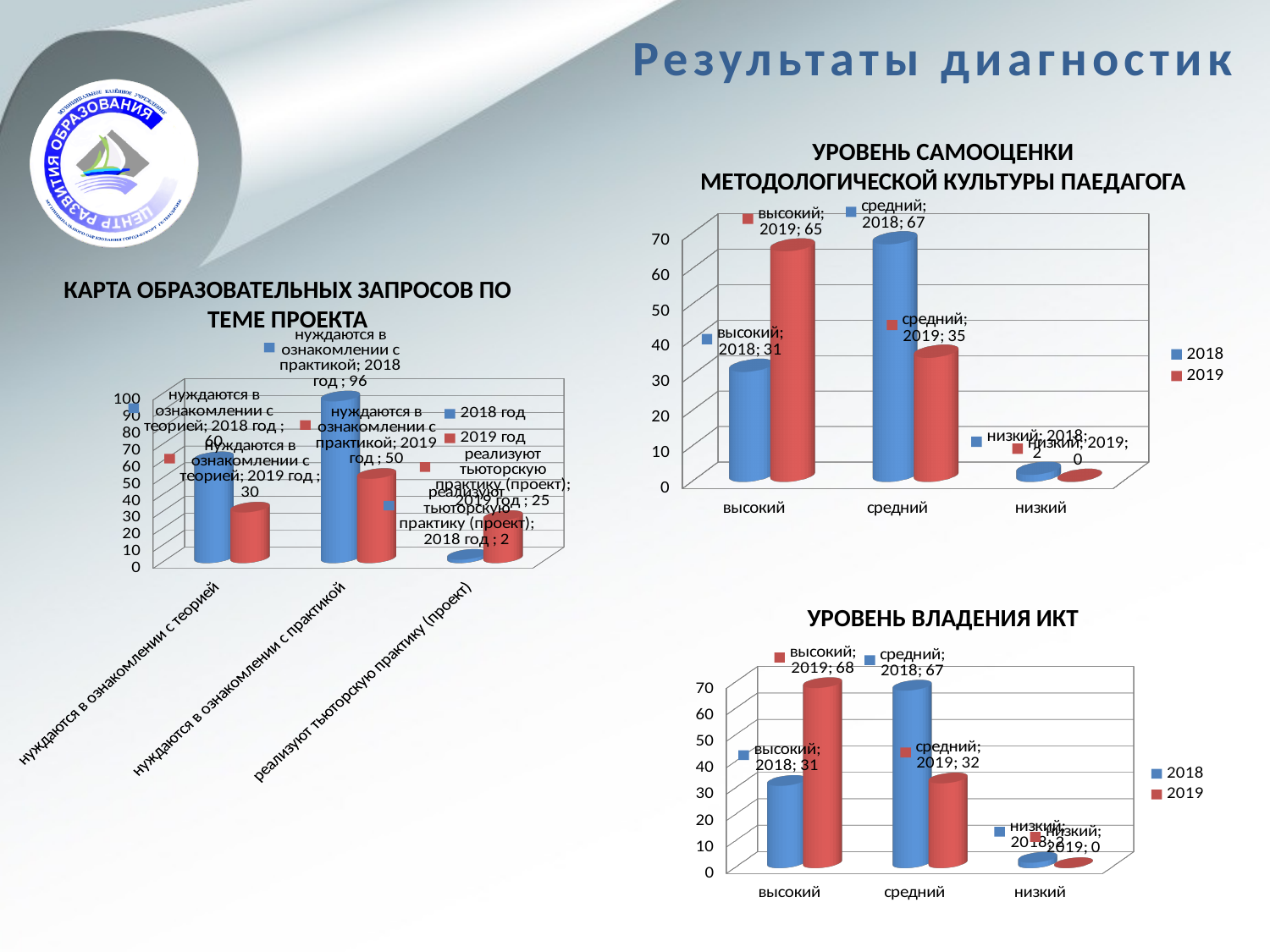
In the chart 'УРОВЕНЬ САМООЦЕНКИ МЕТОДОЛОГИЧЕСКОЙ КУЛЬТУРЫ ПАЕДАГОГА', which category has the highest 2018 value? средний In the chart 'КАРТА ОБРАЗОВАТЕЛЬНЫХ ЗАПРОСОВ ПО ТЕМЕ ПРОЕКТА', what is the 2018 год value for 'нуждаются в ознакомлении с практикой'? 96 In the chart 'УРОВЕНЬ ВЛАДЕНИЯ ИКТ', what is the 2019 value for 'высокий'? 68 What kind of chart is 'УРОВЕНЬ ВЛАДЕНИЯ ИКТ'? bar chart In the chart 'УРОВЕНЬ ВЛАДЕНИЯ ИКТ', which is larger for 'средний': the 2018 value or the 2019 value? 2018 In the chart 'УРОВЕНЬ САМООЦЕНКИ МЕТОДОЛОГИЧЕСКОЙ КУЛЬТУРЫ ПАЕДАГОГА', what is the 2019 value for 'высокий'? 65 In the chart 'УРОВЕНЬ ВЛАДЕНИЯ ИКТ', which category has the lowest 2019 value? низкий In the chart 'КАРТА ОБРАЗОВАТЕЛЬНЫХ ЗАПРОСОВ ПО ТЕМЕ ПРОЕКТА', what is the 2019 год value for 'нуждаются в ознакомлении с теорией'? 30 In the chart 'КАРТА ОБРАЗОВАТЕЛЬНЫХ ЗАПРОСОВ ПО ТЕМЕ ПРОЕКТА', what is the difference between the 2018 год and 2019 год values for 'реализуют тьюторскую практику (проект)'? 23 In the chart 'КАРТА ОБРАЗОВАТЕЛЬНЫХ ЗАПРОСОВ ПО ТЕМЕ ПРОЕКТА', how many categories are shown on the x axis? 3 In the chart 'УРОВЕНЬ САМООЦЕНКИ МЕТОДОЛОГИЧЕСКОЙ КУЛЬТУРЫ ПАЕДАГОГА', how many series does the legend list? 2 In the chart 'УРОВЕНЬ САМООЦЕНКИ МЕТОДОЛОГИЧЕСКОЙ КУЛЬТУРЫ ПАЕДАГОГА', what is the difference between the 2018 and 2019 values for 'средний'? 32